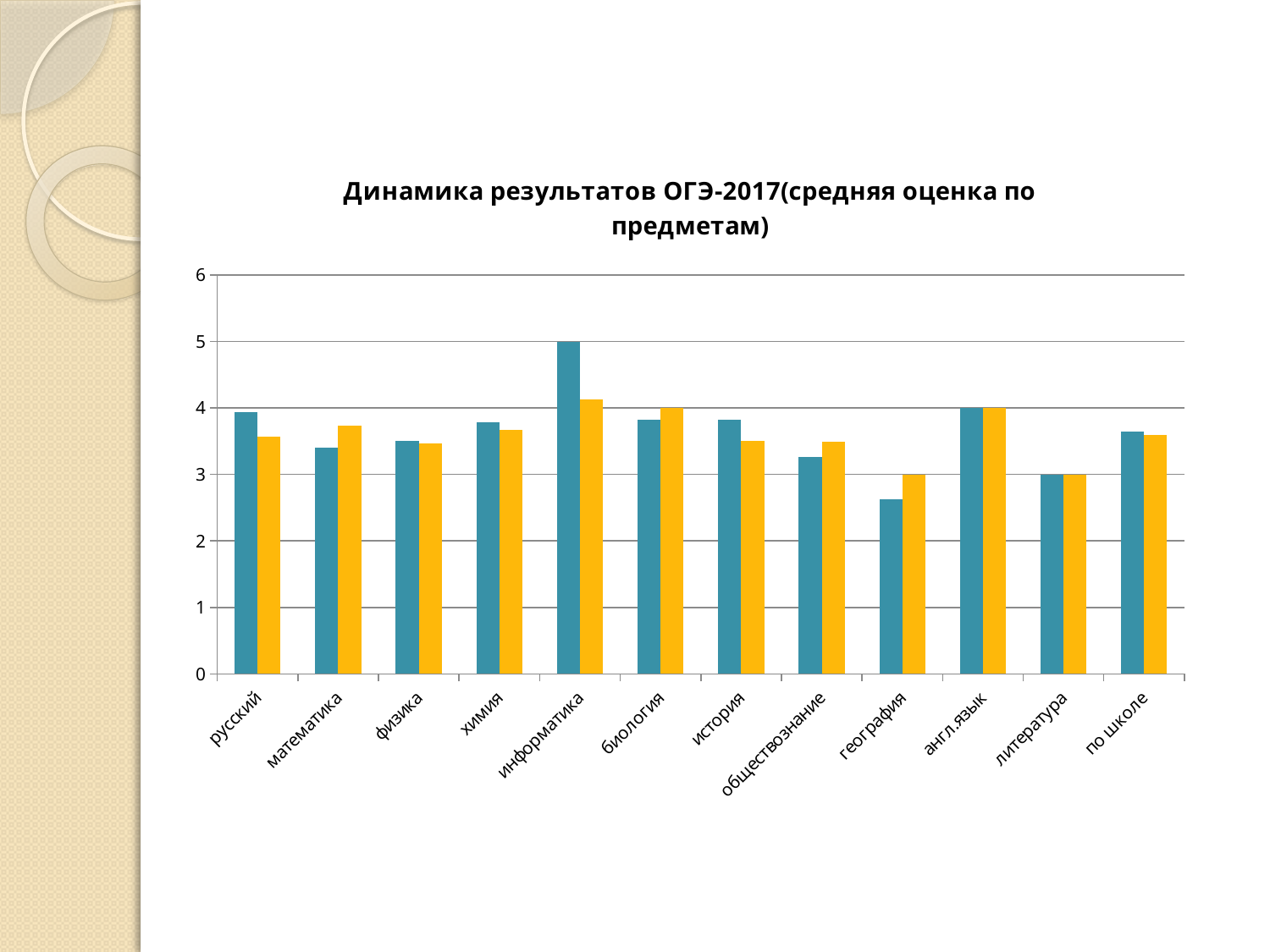
For математика, which bar is taller, the blue one or the yellow one? yellow Which category has the highest blue bar? информатика Which category has the lowest blue bar? география What kind of chart is shown on the slide? bar chart What is the title of the chart? Динамика результатов ОГЭ-2017(средняя оценка по предметам) How many subject categories are shown along the x axis? 12 For русский, which bar is taller, the blue one or the yellow one? blue Which category has the highest yellow bar? информатика Is the blue bar for география greater or less than 3? less How many data series (bar colours) are plotted for each category? 2 Is the yellow bar for информатика greater or less than 4? greater Is the blue bar for информатика greater or less than 4? greater